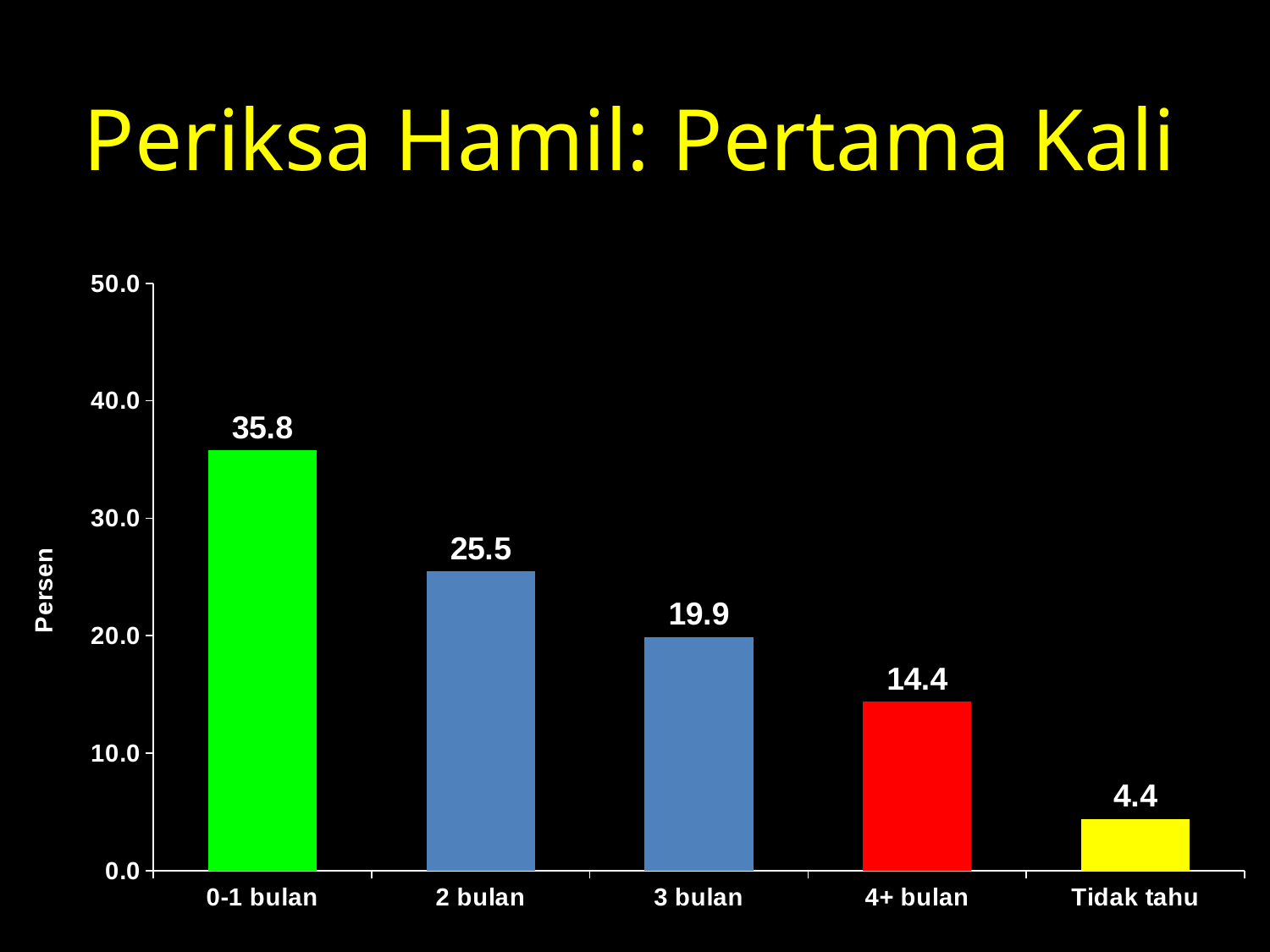
What is the value for Tidak tahu? 4.4 Which is larger, the value for 2 bulan or the value for 3 bulan? 2 bulan What is the difference between the values for 2 bulan and 4+ bulan? 11.1 How many categories are shown on the x axis? 5 What is the value for 0-1 bulan? 35.8 What kind of chart is shown on the slide? bar chart Do the values rise or fall from left to right along the x axis? fall What is the title of the slide? Periksa Hamil: Pertama Kali Which category has the lowest value? Tidak tahu Which category has the highest value? 0-1 bulan Is the value for 4+ bulan greater or less than 20.0? less What is the value for 3 bulan? 19.9